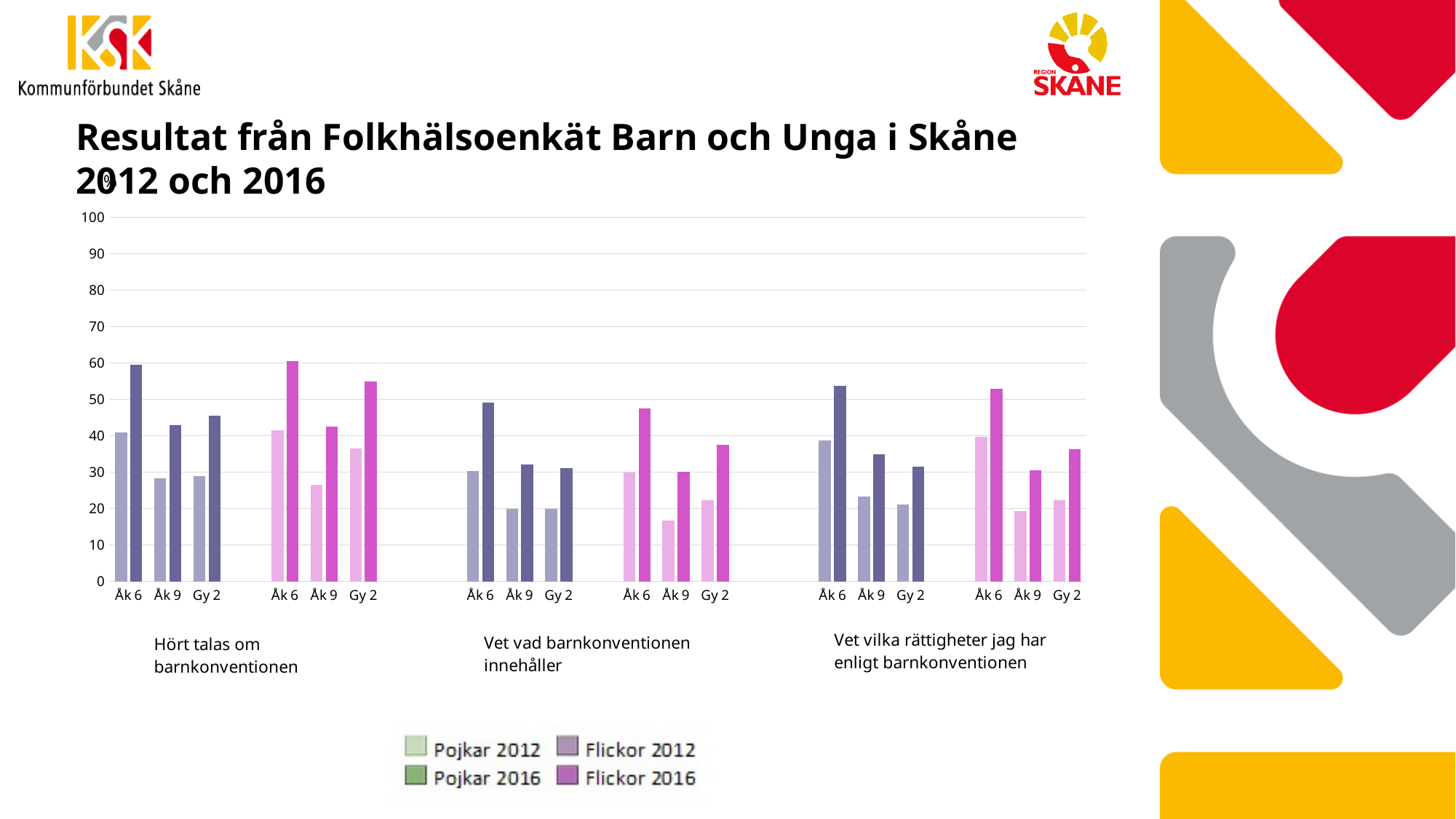
In the 'Hört talas om barnkonventionen' group, which dark pink bar is taller: Åk 6 or Gy 2? Åk 6 How many series does the legend list? 4 How many question categories (labelled groups) are shown along the x axis of the chart? 3 In the 'Vet vilka rättigheter jag har enligt barnkonventionen' group, is the light purple bar for Gy 2 greater or less than 30? less What kind of chart is shown on the slide? Bar chart What are the four entries in the chart legend? Pojkar 2012, Pojkar 2016, Flickor 2012, Flickor 2016 What is the highest value shown on the y axis of the chart? 100 In the 'Vet vilka rättigheter jag har enligt barnkonventionen' group, which dark pink bar is taller: Åk 9 or Gy 2? Gy 2 In the 'Vet vilka rättigheter jag har enligt barnkonventionen' group, is the dark purple bar for Åk 6 greater or less than 50? greater Which of the three question groups contains the tallest bars in the chart? Hört talas om barnkonventionen In the 'Vet vad barnkonventionen innehåller' group, is the light pink bar for Åk 9 greater or less than 20? less